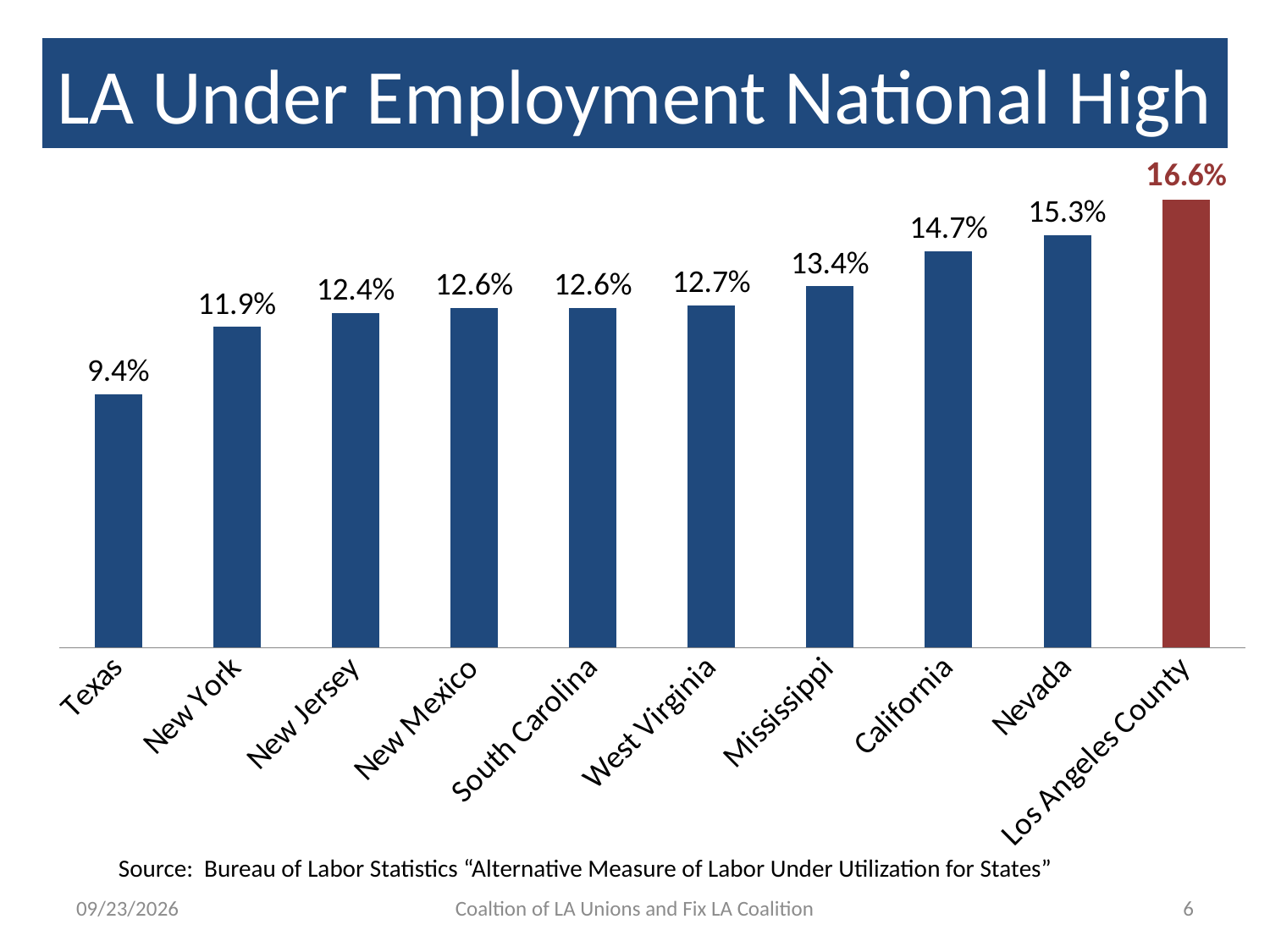
What is the difference between the values for Los Angeles County and Nevada? 1.3% What is the value for California? 14.7% What is the difference between the values for New York and Texas? 2.5% What kind of chart is shown on the slide? Bar chart What is the value for Texas? 9.4% What is the value for Los Angeles County? 16.6% Which is larger, the value for California or the value for Mississippi? California What is the value for Mississippi? 13.4% Do the values rise or fall from left to right along the x axis? Rise Which category has the highest value? Los Angeles County How many categories are shown in the chart? 10 Which category has the lowest value? Texas